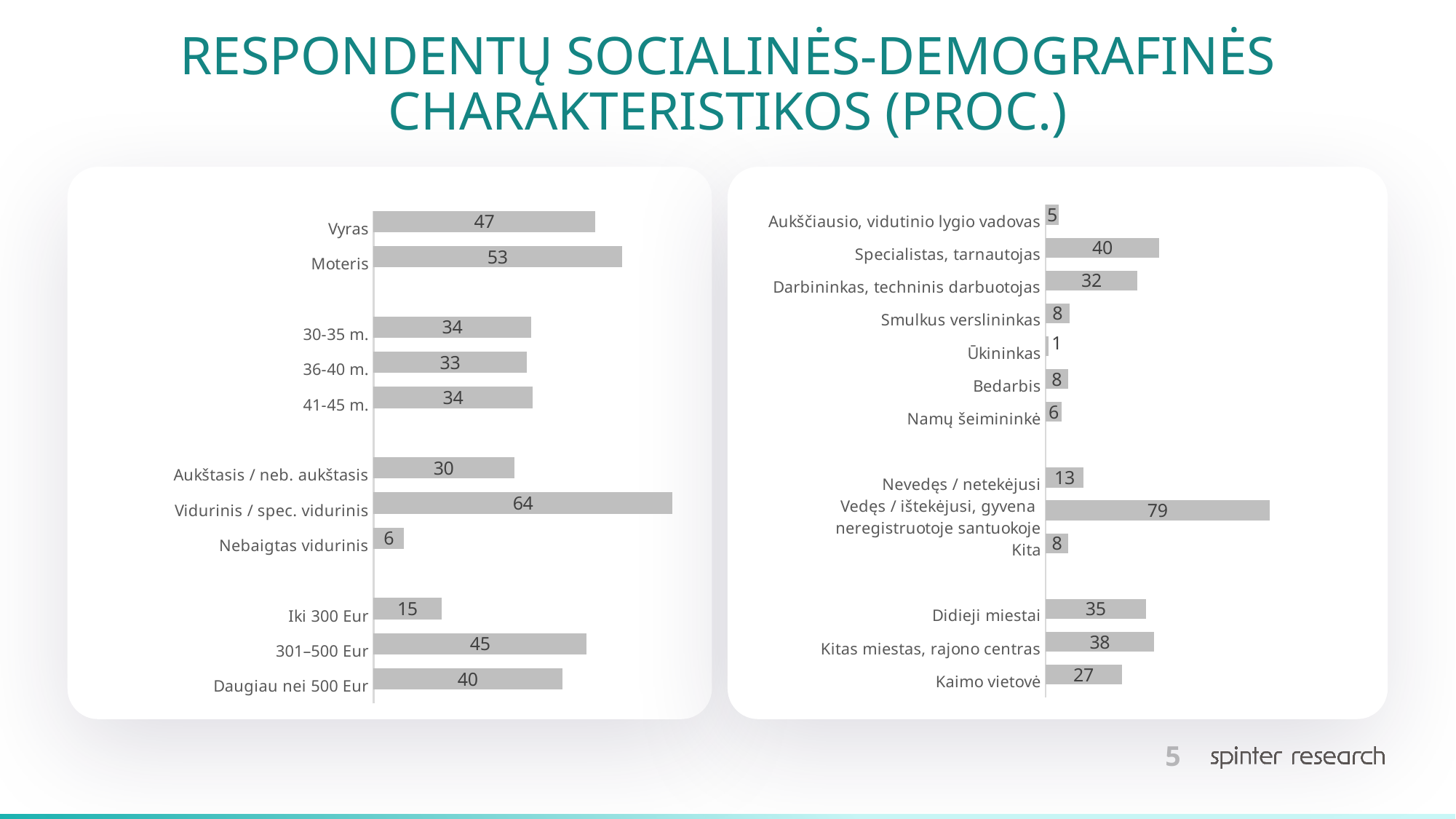
In the left chart, what is the difference between the values for 301–500 Eur and Iki 300 Eur? 30 What kind of chart is the right chart? Bar chart In the left chart, how many categories are plotted? 11 In the left chart, which is larger, the value for Vyras or the value for Moteris? Moteris In the left chart, what is the value for Vidurinis / spec. vidurinis? 64 In the left chart, which category has the lowest value? Nebaigtas vidurinis In the right chart, which category has the lowest value? Ūkininkas In the right chart, which category has the highest value? Vedęs / ištekėjusi, gyvena neregistruotoje santuokoje In the right chart, how many categories are plotted? 13 In the right chart, what is the value for Specialistas, tarnautojas? 40 In the right chart, what is the difference between the values for Kitas miestas, rajono centras and Kaimo vietovė? 11 In the left chart, what is the value for Moteris? 53